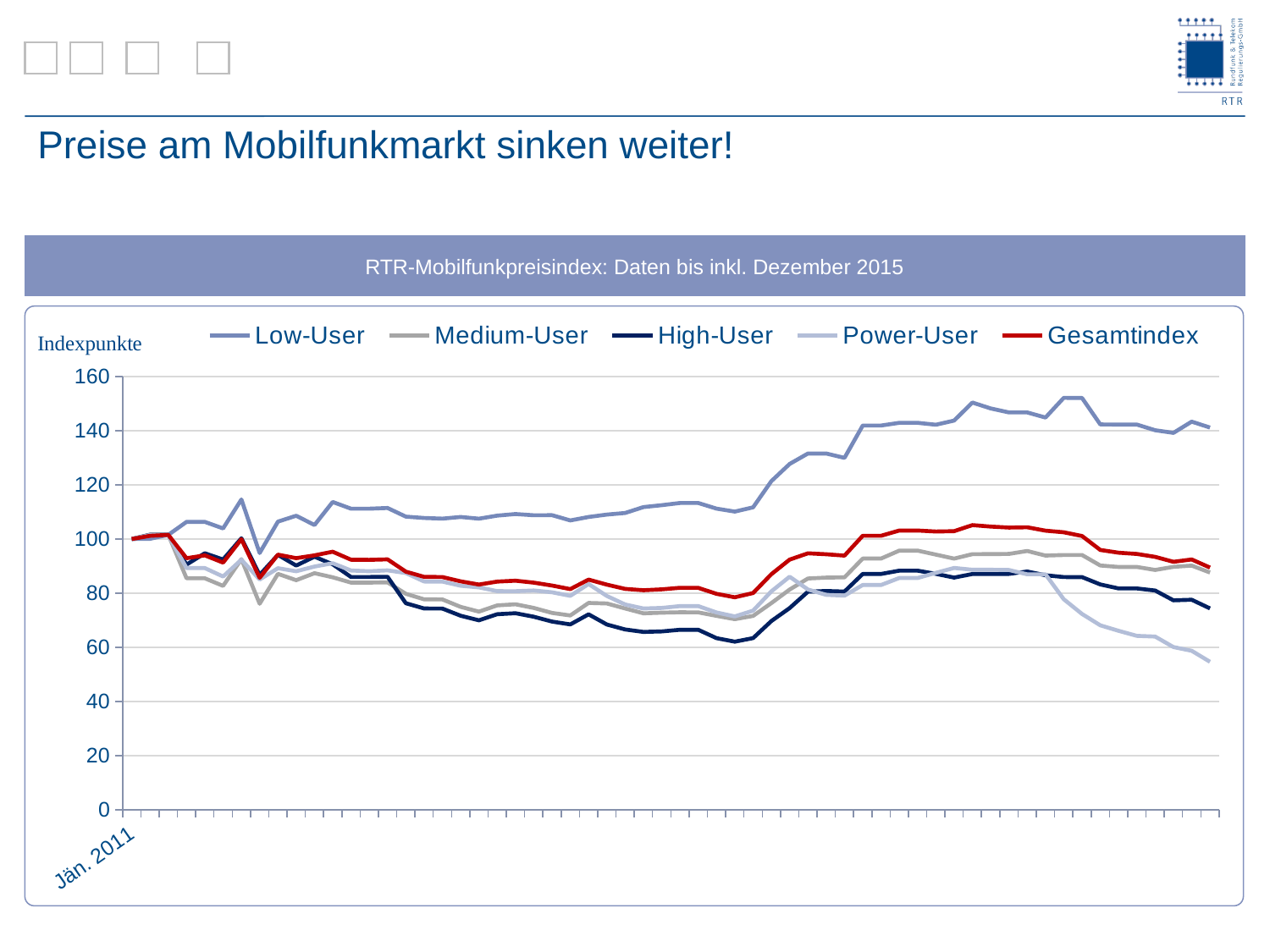
What is the value of the Gesamtindex series at Jän. 2011? 100 Which series has the highest value at the right end of the chart? Low-User Does the Power-User series rise or fall over the final part of the chart? fall What kind of chart is shown on the slide? line chart Is the value of the Power-User series at the right end of the chart greater or less than 60? less What is the title shown above the chart? RTR-Mobilfunkpreisindex: Daten bis inkl. Dezember 2015 How many series does the legend list? 5 Is the peak value of the Low-User series greater or less than 140? greater Is the value of the Gesamtindex series at the right end of the chart greater or less than 100? less Which series has the lowest value at the right end of the chart? Power-User At the right end of the chart, which is larger: the Low-User value or the High-User value? Low-User What label is shown on the y axis of the chart? Indexpunkte